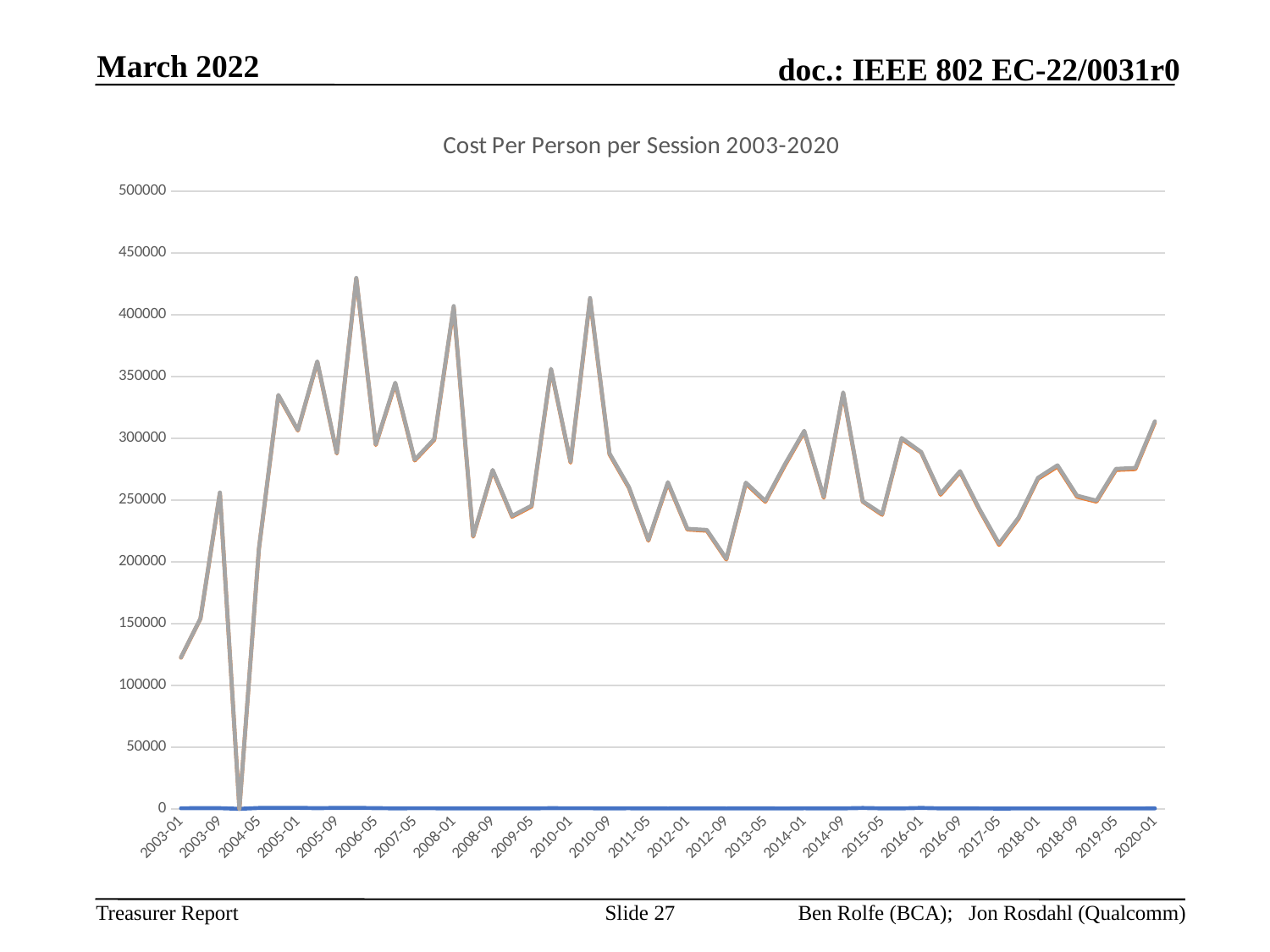
Is the value for 2020-01 greater or less than 300000? greater What kind of chart is shown on the slide? line chart Is the value for 2003-01 greater or less than 150000? less What is the highest value shown on the vertical axis? 500000 Is the value for 2014-09 greater or less than 300000? greater Which is larger, the value for 2005-01 or the value for 2017-05? 2005-01 What is the title of the chart? Cost Per Person per Session 2003-2020 Do the values rise or fall from 2017-05 to 2020-01? rise